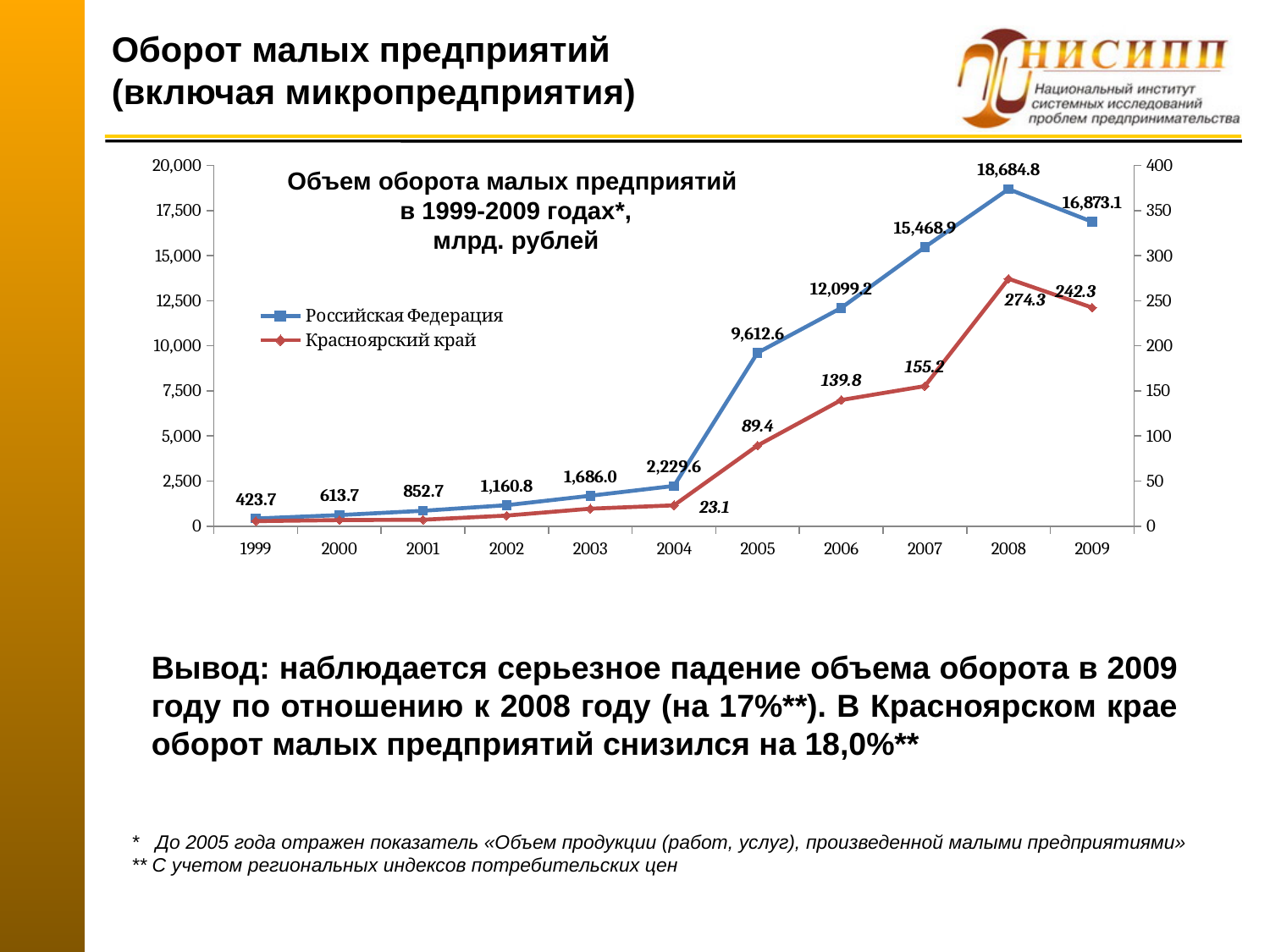
What kind of chart is shown on the slide? line chart In which year does the Российская Федерация series reach its highest value? 2008 In which year is the Российская Федерация value lowest? 1999 What is the difference between the Российская Федерация values for 2008 and 2009? 1,811.7 Is the value for Красноярский край in 2001 greater or less than 50 on the right-hand axis? less What is the value for Красноярский край in 2009? 242.3 What is the difference between the Красноярский край values for 2008 and 2009? 32.0 What is the value for Российская Федерация in 2008? 18,684.8 Which is larger for Красноярский край: the 2006 value or the 2007 value? 2007 How many series does the legend list? 2 What is the value for Российская Федерация in 2004? 2,229.6 How many years are shown on the x axis? 11